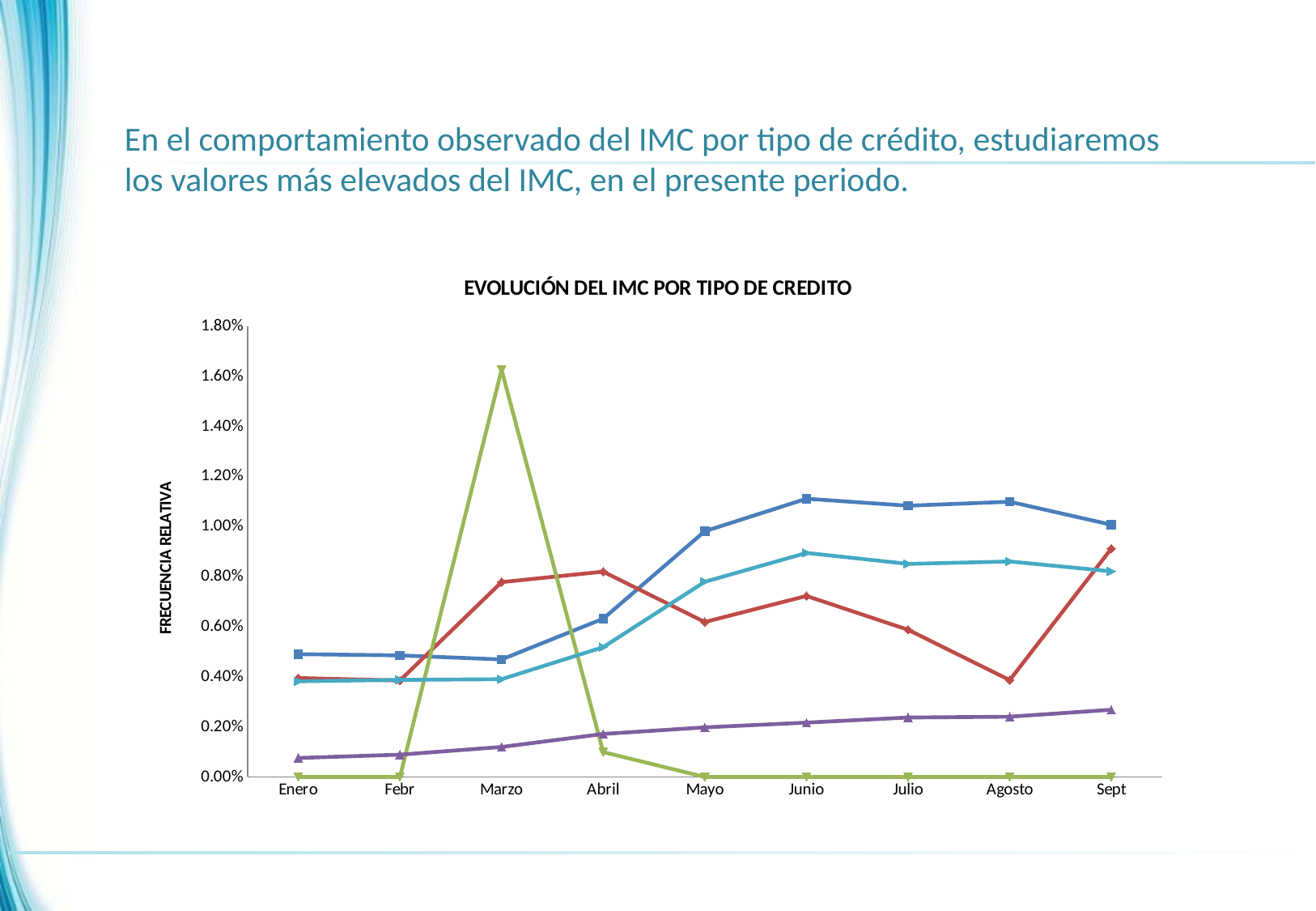
Is the value of the dark blue line in Junio greater or less than 1.00%? greater How many months are shown on the x axis? 9 Is the value of the purple line in Sept greater or less than 0.40%? less What is the title of the chart? EVOLUCIÓN DEL IMC POR TIPO DE CREDITO In which month does the green line reach its highest value? Marzo What kind of chart is shown on the slide? line chart Does the purple line rise or fall from Enero to Sept? rise What is the value of the green line in Junio? 0.00% What is the label of the vertical axis? FRECUENCIA RELATIVA In Junio, which line has the larger value, the dark blue line or the red line? the dark blue line How many lines are plotted on the chart? 5 Is the value of the green line in Marzo greater or less than 1.40%? greater